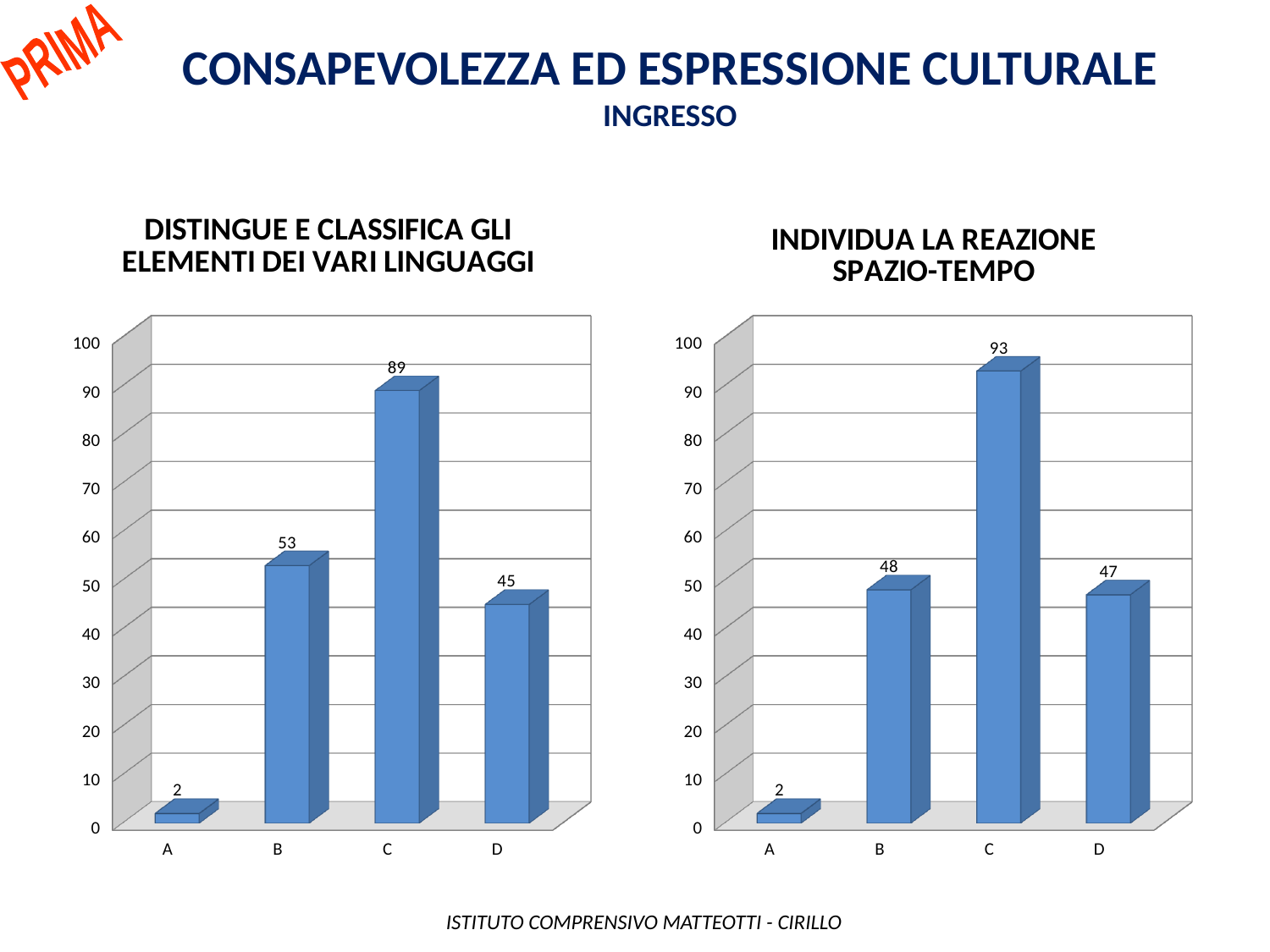
In the left chart, which category has the lowest value? A In the chart titled 'DISTINGUE E CLASSIFICA GLI ELEMENTI DEI VARI LINGUAGGI', what is the value for category C? 89 In the right chart, is the value for C greater or less than 90? greater How many categories are shown in the chart titled 'INDIVIDUA LA REAZIONE SPAZIO-TEMPO'? 4 In the left chart, what is the difference between the values for C and B? 36 In the right chart, what is the difference between the values for C and D? 46 In the chart titled 'INDIVIDUA LA REAZIONE SPAZIO-TEMPO', what is the value for category B? 48 What is the title of the chart on the right side of the slide? INDIVIDUA LA REAZIONE SPAZIO-TEMPO In the right chart, which category has the highest value? C In the left chart, what is the value for category A? 2 What kind of chart is the chart titled 'DISTINGUE E CLASSIFICA GLI ELEMENTI DEI VARI LINGUAGGI'? Bar chart In the left chart, which is larger, the value for B or the value for D? B